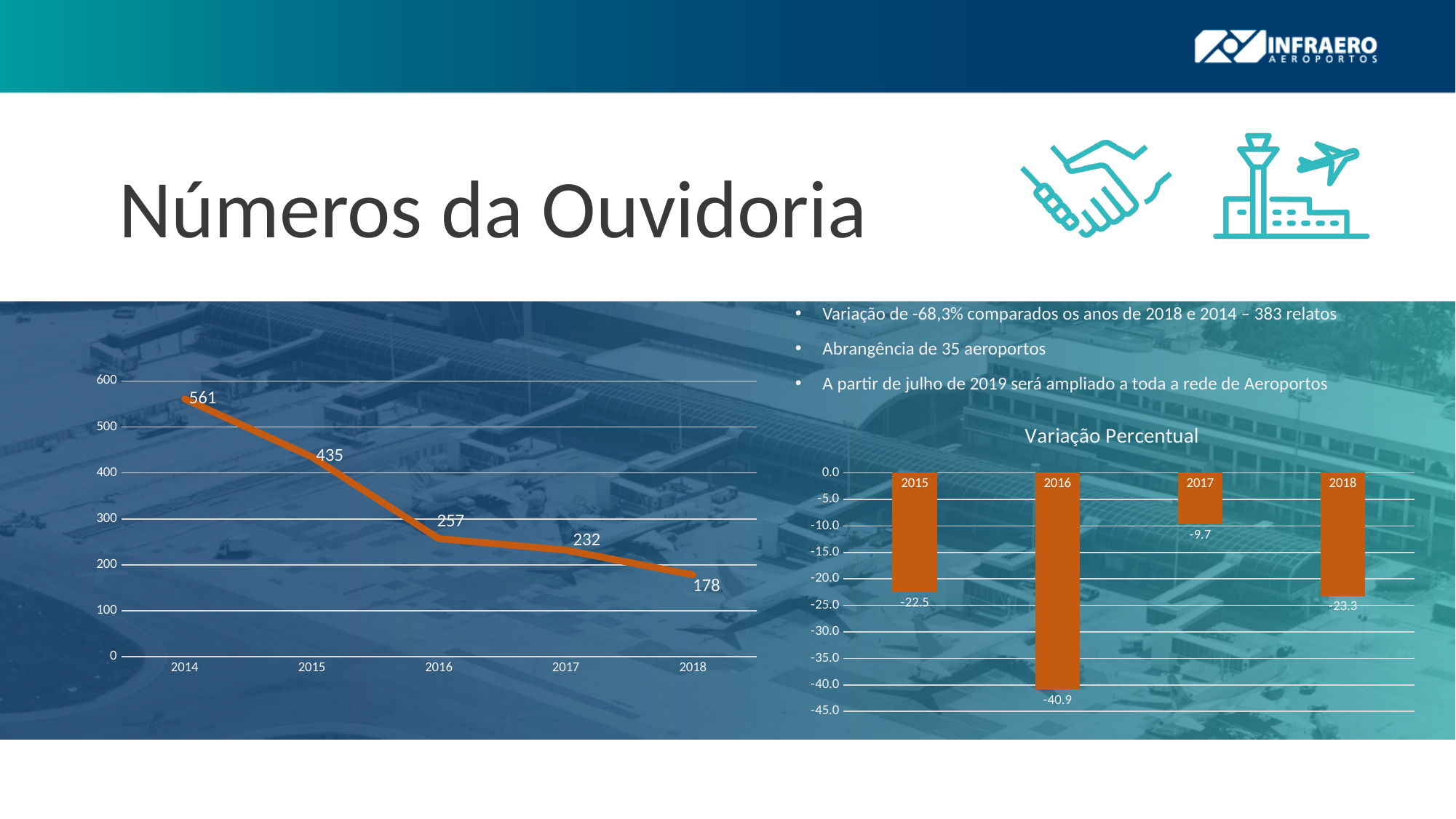
In the 'Variação Percentual' chart, what is the value for 2016? -40.9 In the line chart on the left, what is the value for 2014? 561 In the 'Variação Percentual' chart, which year has the lowest value? 2016 In the line chart on the left, which year has the lowest value? 2018 In the line chart on the left, how many years are plotted? 5 In the 'Variação Percentual' chart, what is the value for 2017? -9.7 In the line chart on the left, what is the value for 2018? 178 What kind of chart is the chart on the left? line chart In the 'Variação Percentual' chart, which is larger, the value for 2015 or the value for 2018? 2015 In the line chart on the left, what is the difference between the values for 2014 and 2015? 126 What kind of chart is the 'Variação Percentual' chart? bar chart In the line chart on the left, do the values rise or fall from 2014 to 2018? fall